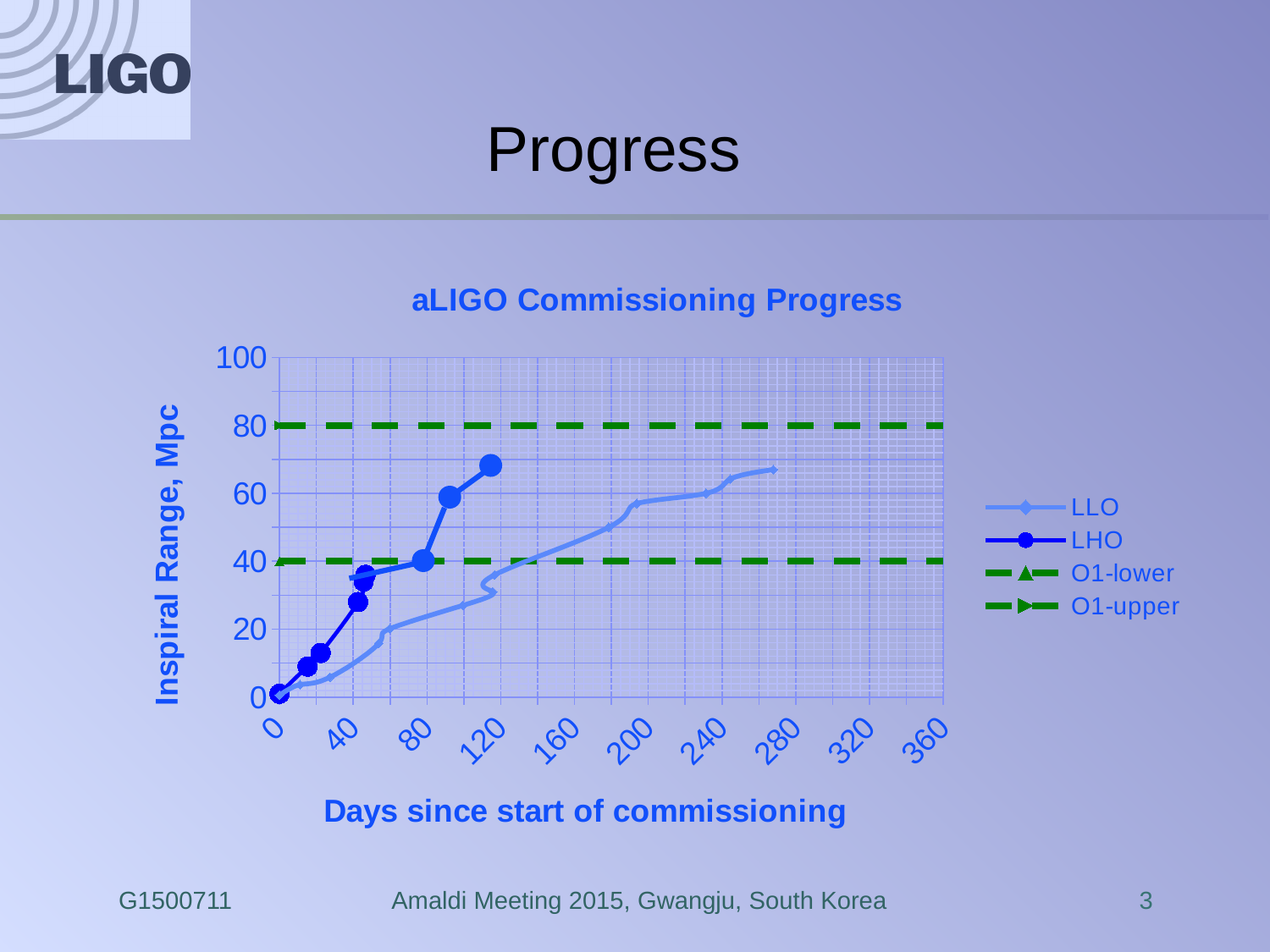
At what inspiral range does the O1-upper dashed line sit? 80 Is the final LHO value greater or less than 60 Mpc? greater Which is higher, the O1-upper line or the O1-lower line? O1-upper Is the LLO value at 200 days greater or less than 40 Mpc? greater Which series extends further along the x axis, LLO or LHO? LLO What is the title of the chart? aLIGO Commissioning Progress Does the LHO inspiral range rise or fall as days since start of commissioning increase? rise What is the difference in Mpc between the O1-upper and O1-lower lines? 40 How many series does the legend list? 4 At what inspiral range does the O1-lower dashed line sit? 40 What kind of chart is shown on the slide? line chart What is the label of the y axis? Inspiral Range, Mpc